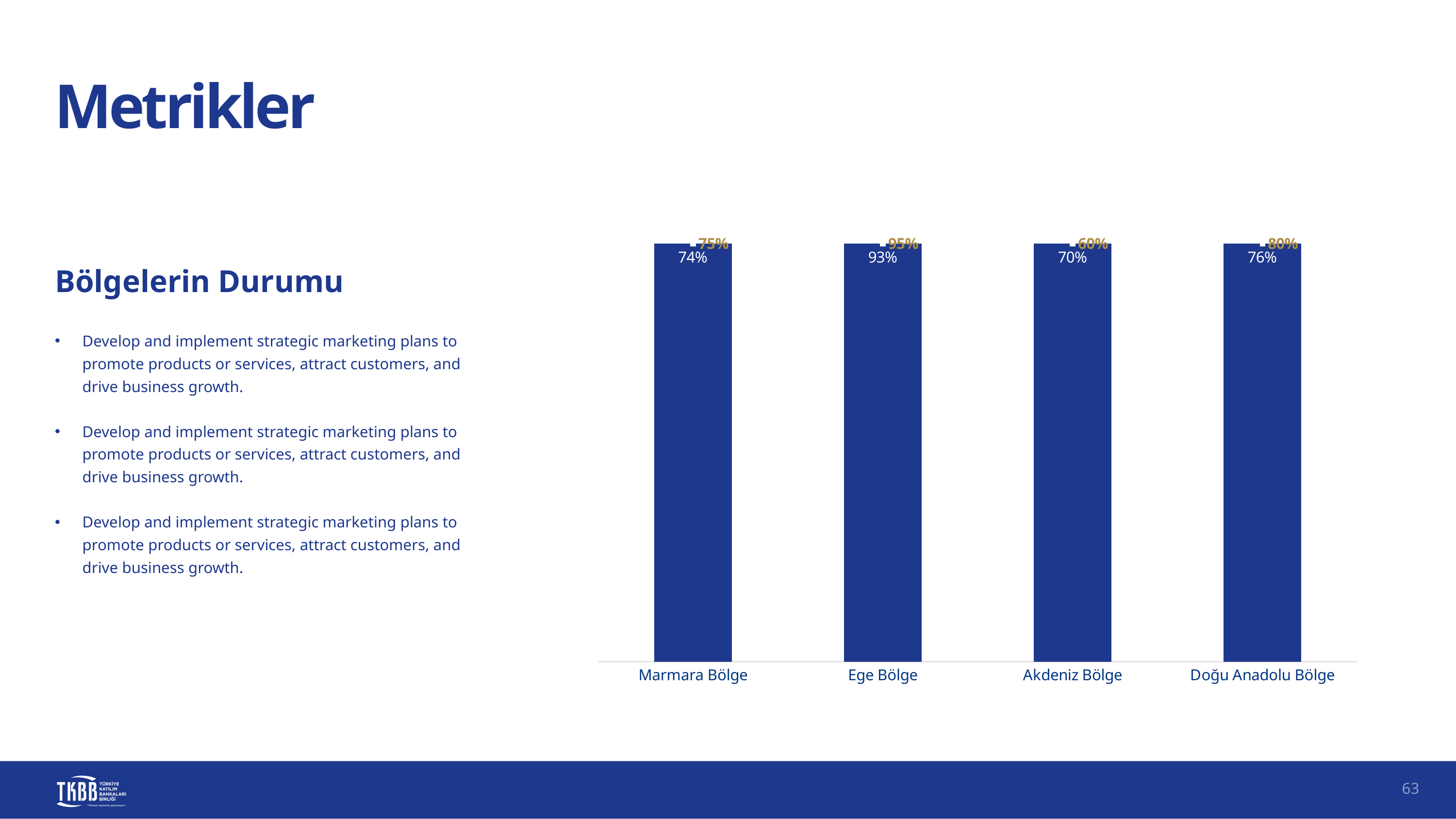
What is the white data label value shown for Marmara Bölge? 74% What kind of chart is shown on the slide? bar chart What is the heading shown to the left of the chart? Bölgelerin Durumu Which region has the lowest gold data label value? Akdeniz Bölge For Akdeniz Bölge, which is larger: the white data label value or the gold data label value? the white data label value (70%) What is the gold data label value shown for Doğu Anadolu Bölge? 80% What is the gold data label value shown for Ege Bölge? 95% What is the difference between the white data label values for Ege Bölge and Marmara Bölge? 19 percentage points What colour are the bars in the chart? dark blue Which region has the highest white data label value? Ege Bölge How many regions (categories) are shown on the x axis of the chart? 4 What is the white data label value shown for Akdeniz Bölge? 70%